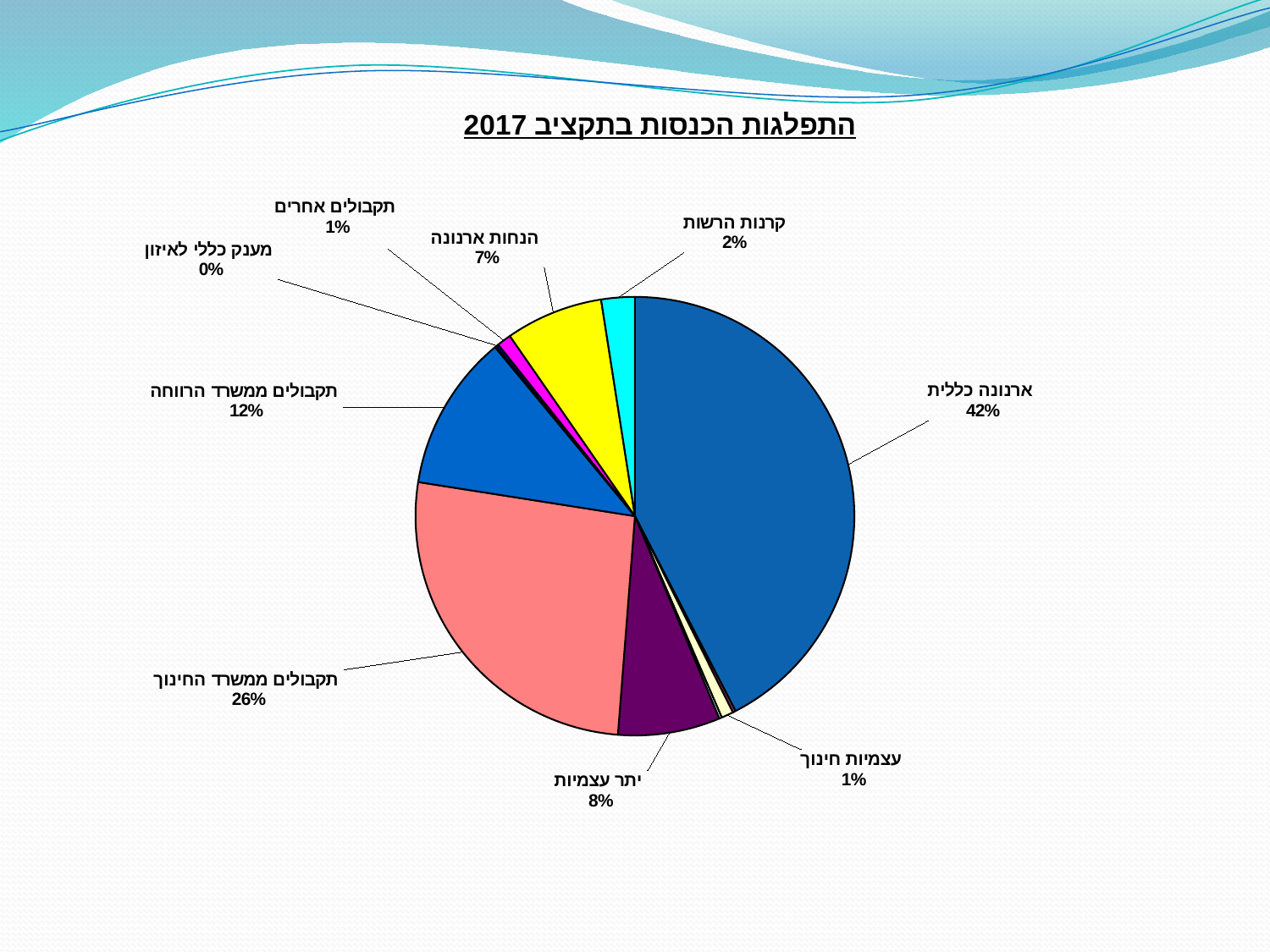
What is the title of the chart? התפלגות הכנסות בתקציב 2017 What percentage is shown for תקבולים ממשרד החינוך? 26% What share of the pie is ארנונה כללית? 42% What percentage is shown for תקבולים ממשרד הרווחה? 12% Which category has the largest share of the pie? ארנונה כללית What percentage is shown for הנחות ארנונה? 7% What percentage is shown for מענק כללי לאיזון? 0% Which is larger, יתר עצמיות or הנחות ארנונה? יתר עצמיות What is the difference in percentage points between ארנונה כללית and תקבולים ממשרד החינוך? 16 What kind of chart is shown on the slide? pie chart